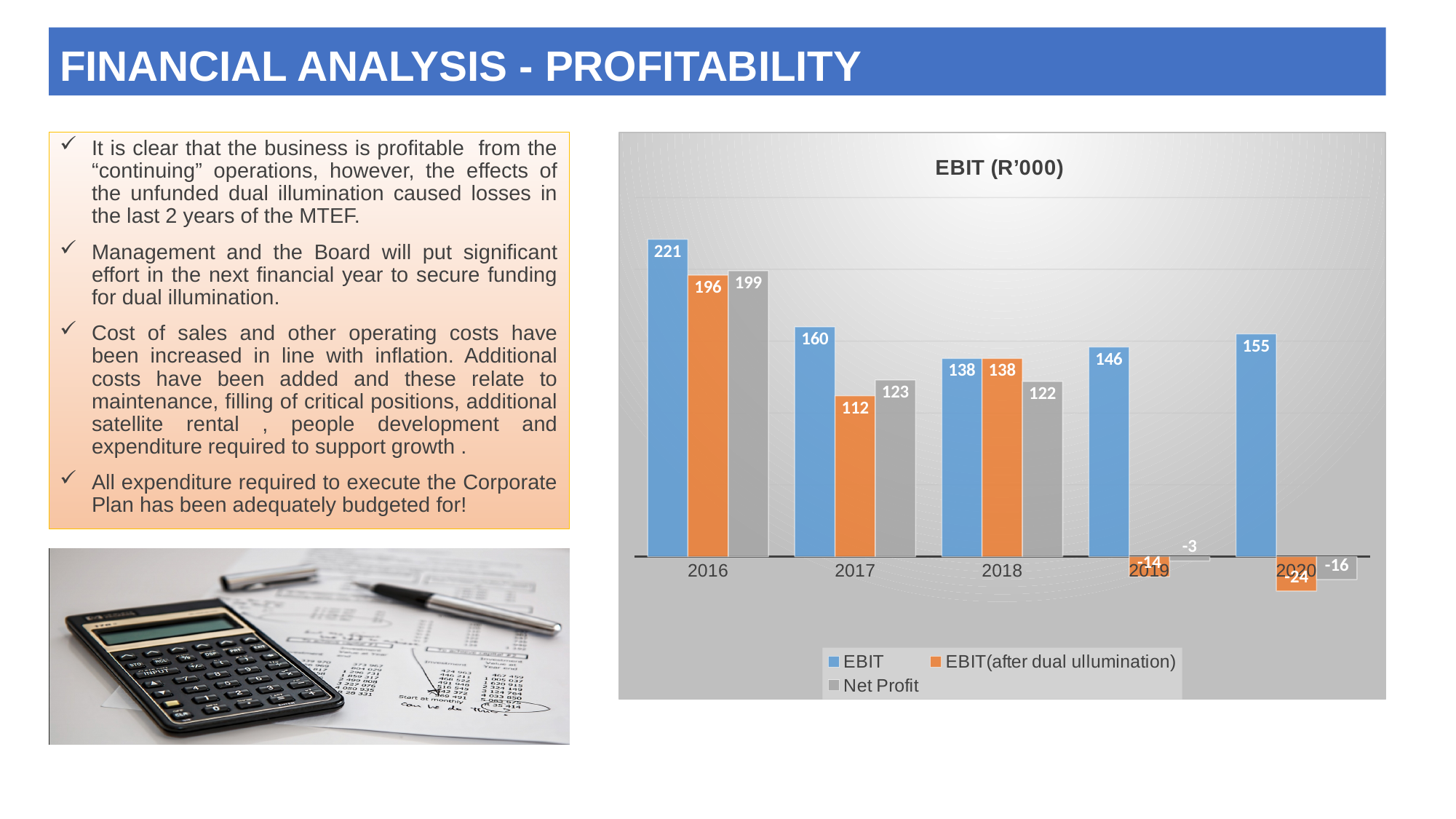
Which is larger in 2018, EBIT or Net Profit? EBIT Which year has the highest EBIT? 2016 What is the difference between EBIT and EBIT(after dual illumination) in 2017? 48 What is the EBIT value for 2016? 221 What is the Net Profit value for 2017? 123 What kind of chart is shown? Bar chart How many series does the legend list? 3 Which year has the lowest Net Profit? 2020 How many years are shown on the x axis? 5 What is the Net Profit value for 2019? -3 What is the title of the chart? EBIT (R'000) What is the EBIT(after dual illumination) value for 2020? -24